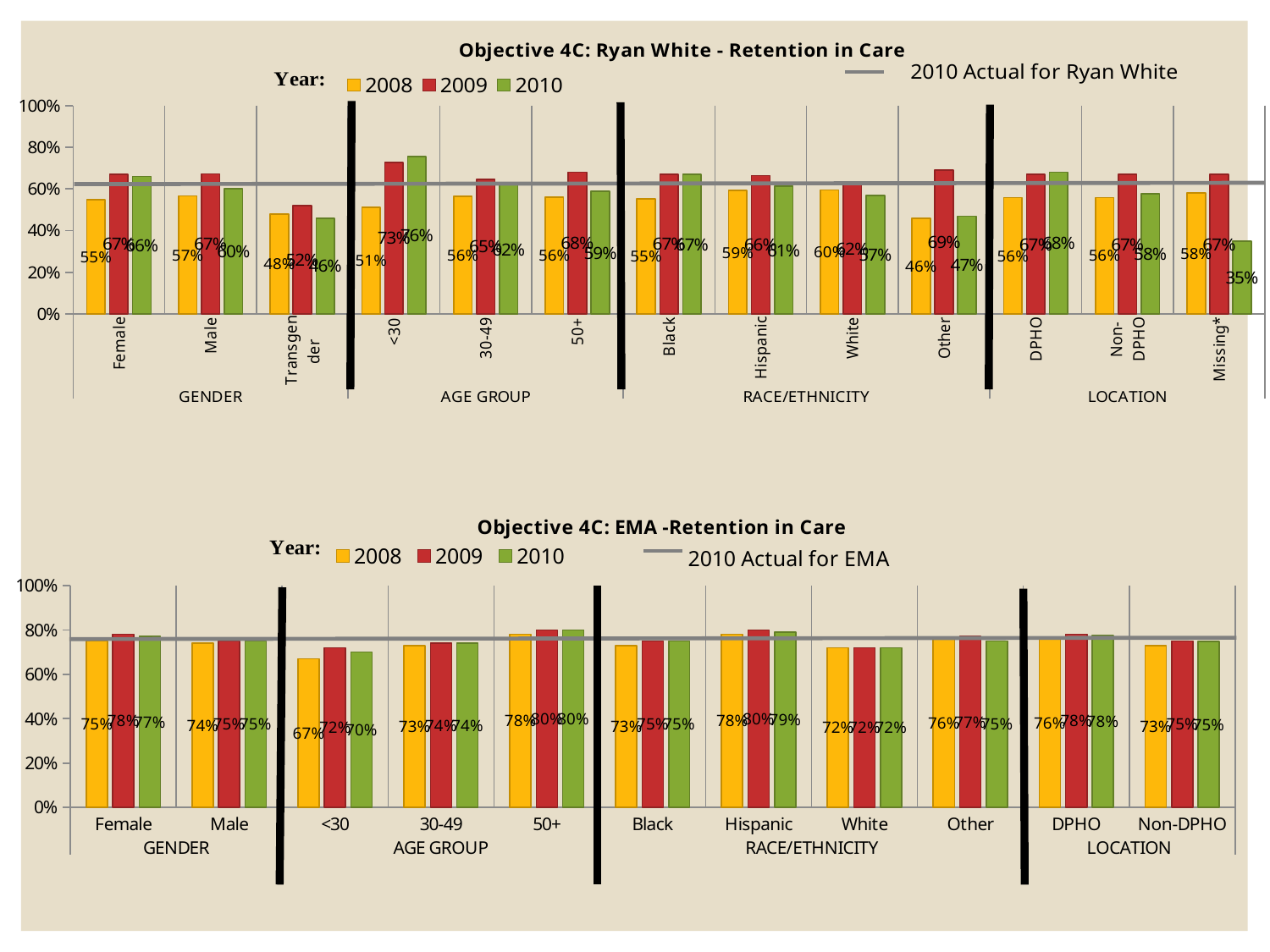
In the Ryan White chart, what is the 2008 retention value for Transgender? 48% In the Ryan White chart, what is the 2010 retention value for Missing*? 35% What kind of chart is the EMA chart? Bar chart In the EMA chart, is the 2009 value for Hispanic or for White larger? Hispanic In the EMA chart, which category has the lowest 2008 value? <30 In the Ryan White chart, which category has the highest 2010 value? <30 In the EMA chart, what does the grey horizontal line represent according to the legend? 2010 Actual for EMA In the Ryan White chart, which category has the lowest 2010 value? Missing* In the EMA chart, what is the 2008 retention value for <30? 67% In the EMA chart, how many categories are shown on the x axis? 11 In the Ryan White chart, what is the difference between the 2009 and 2008 values for Other? 23% In the Ryan White chart, how many series does the legend list? 3